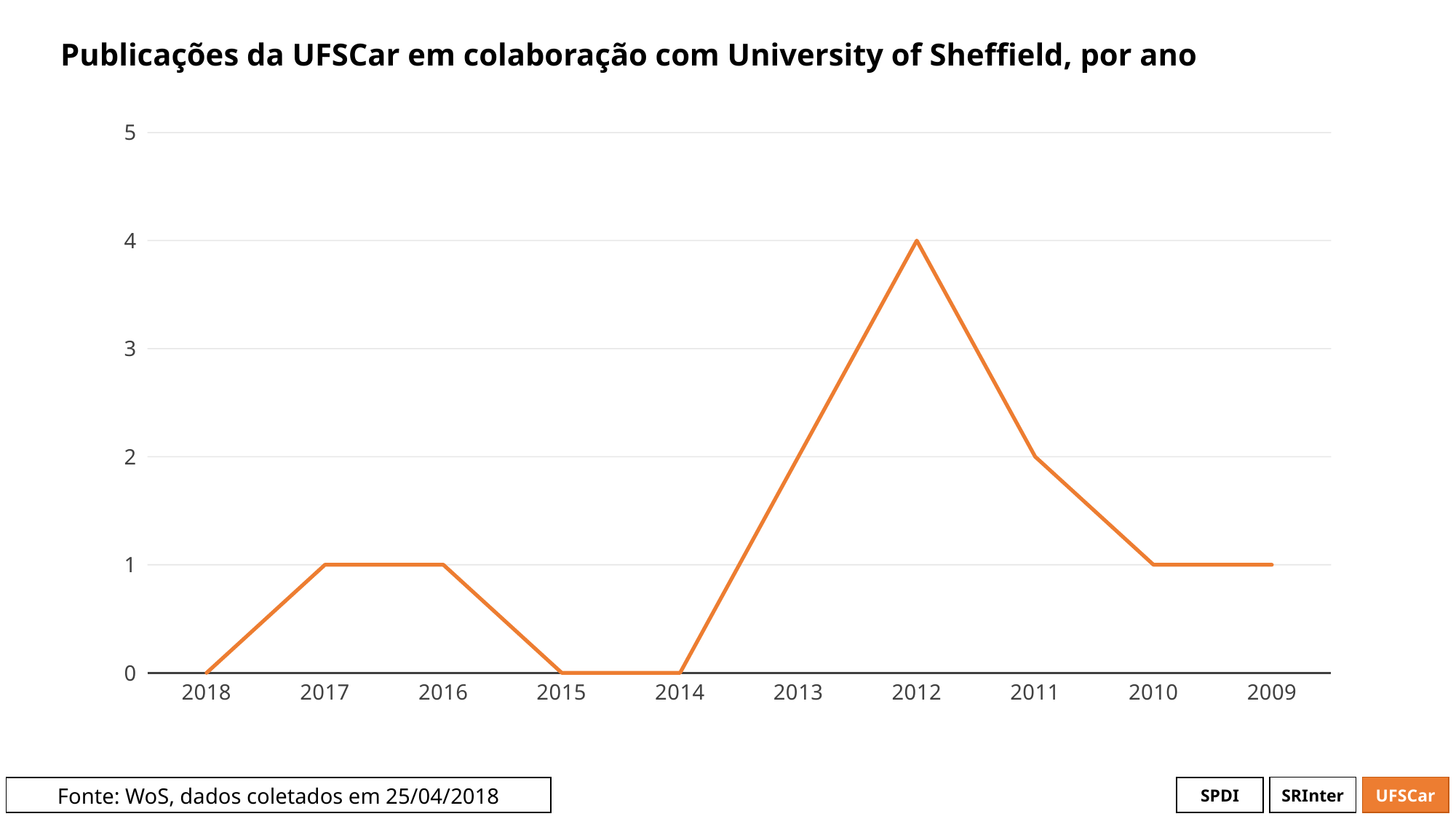
Which year has the highest number of publications? 2012 What is the value for 2018? 0 What is the value for 2017? 1 What is the value for 2012? 4 How many years are plotted on the x axis? 10 Is the value for 2012 greater or less than 3? greater Which is larger, the value for 2012 or the value for 2010? 2012 What kind of chart is shown on the slide? line chart What is the title of the chart? Publicações da UFSCar em colaboração com University of Sheffield, por ano What is the value for 2015? 0 What is the difference between the values for 2012 and 2011? 2 What is the value for 2011? 2